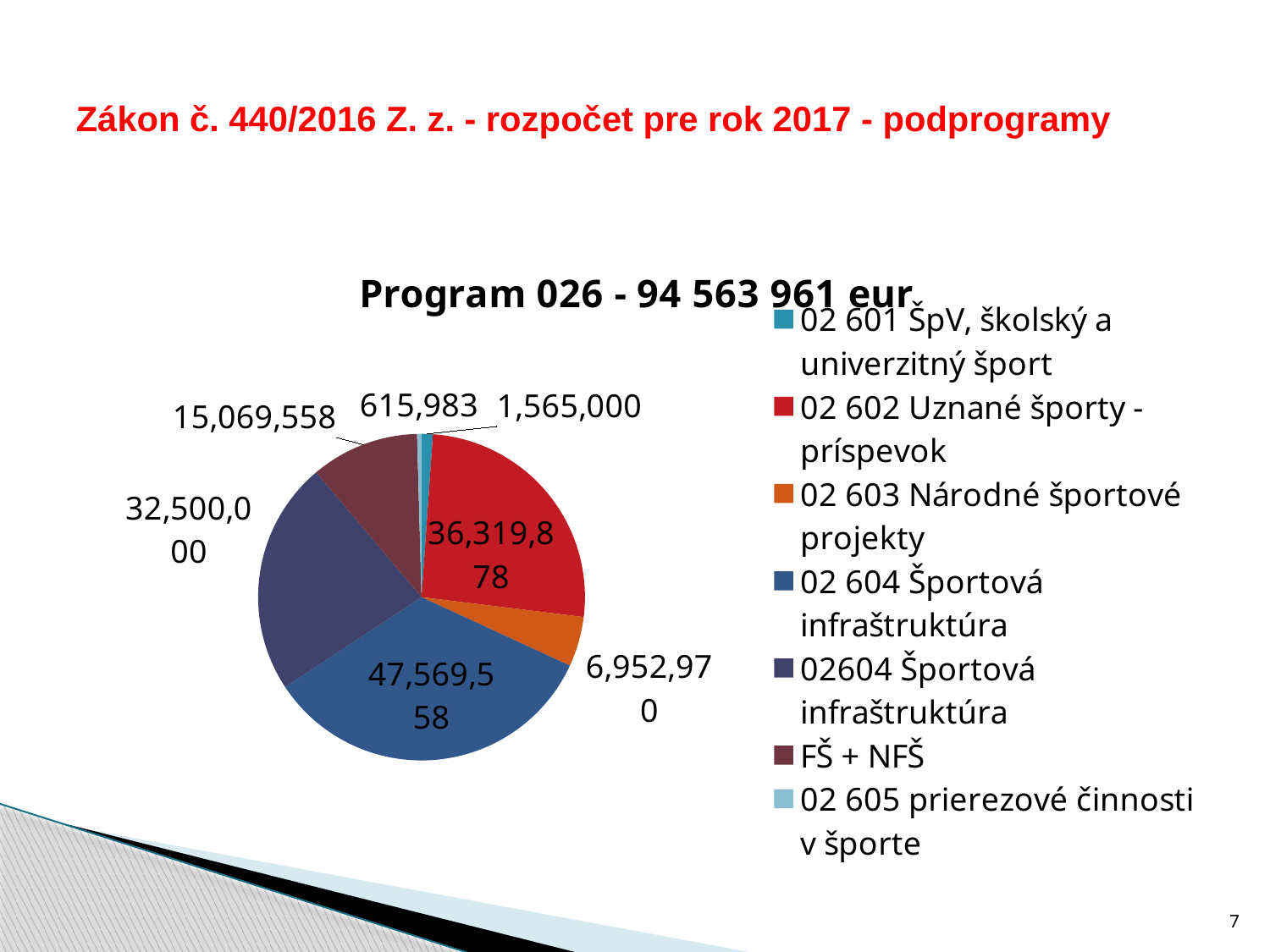
What is the difference between the values for 02 602 Uznané športy - príspevok and FŠ + NFŠ? 21,250,320 What is the value for FŠ + NFŠ? 15,069,558 How many slices does the pie chart have? 7 Which category has the smallest slice in the pie chart? 02 605 prierezové činnosti v športe What is the value for 02 603 Národné športové projekty? 6,952,970 What is the title of the chart? Program 026 - 94 563 961 eur What is the value for 02 602 Uznané športy - príspevok? 36,319,878 What is the value of the largest slice in the pie chart? 47,569,558 Which is larger: the value for 02 603 Národné športové projekty or the value for 02 601 ŠpV, školský a univerzitný šport? 02 603 Národné športové projekty What is the value for 02 601 ŠpV, školský a univerzitný šport? 1,565,000 What is the value for 02 605 prierezové činnosti v športe? 615,983 What type of chart is shown on the slide? Pie chart